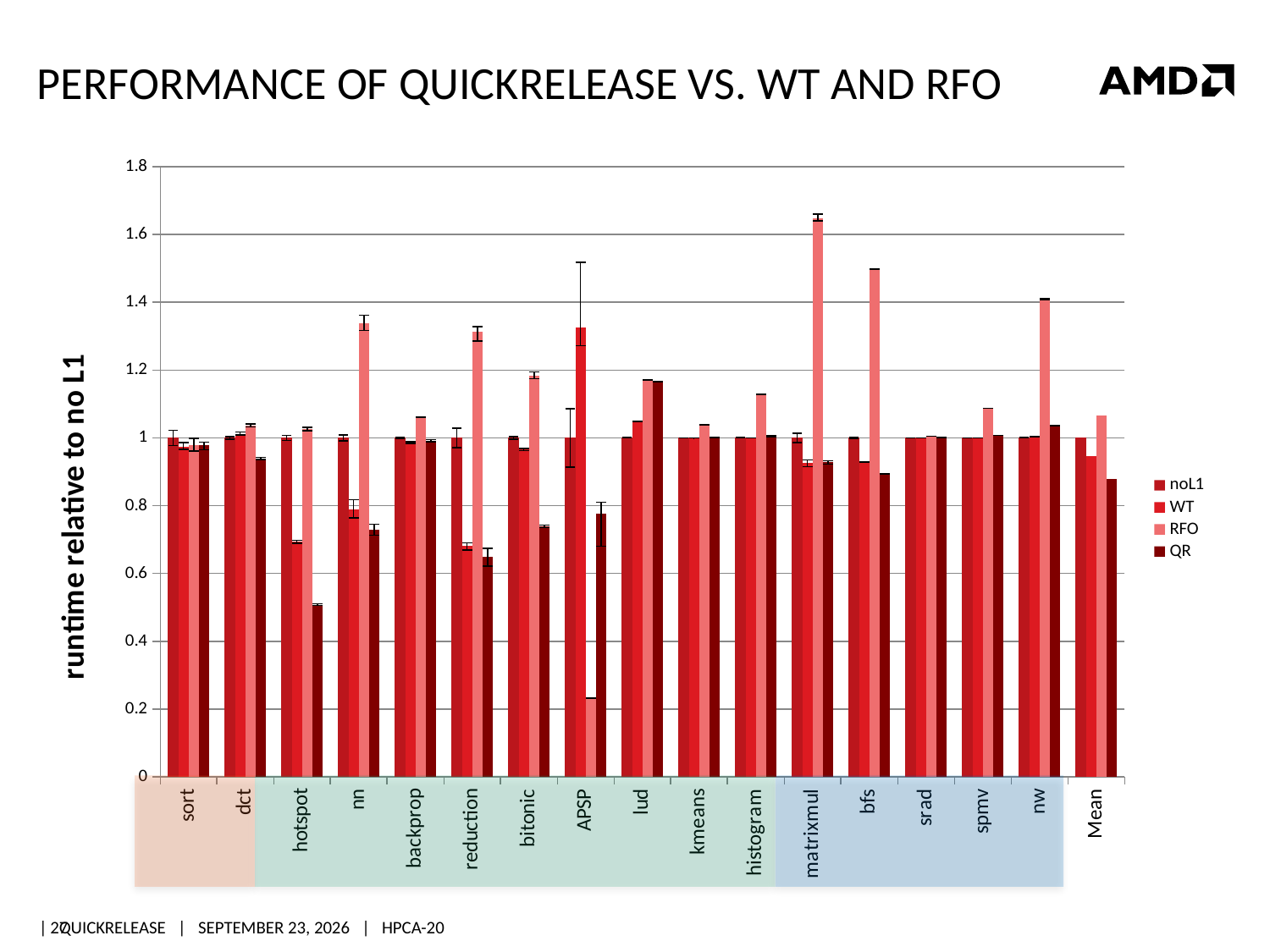
Is the QR value for hotspot greater or less than 0.6? less How many categories are shown along the x axis? 17 Is the RFO value for bfs greater or less than 1.4? greater What is the label of the y axis? runtime relative to no L1 Which is larger, the QR value for hotspot or the QR value for nn? nn What kind of chart is shown on the slide? bar chart Which category has the lowest QR bar? hotspot How many series does the legend list? 4 Which category has the lowest RFO bar? APSP Is the RFO value for nn greater or less than 1.2? greater Which category has the highest RFO bar? matrixmul